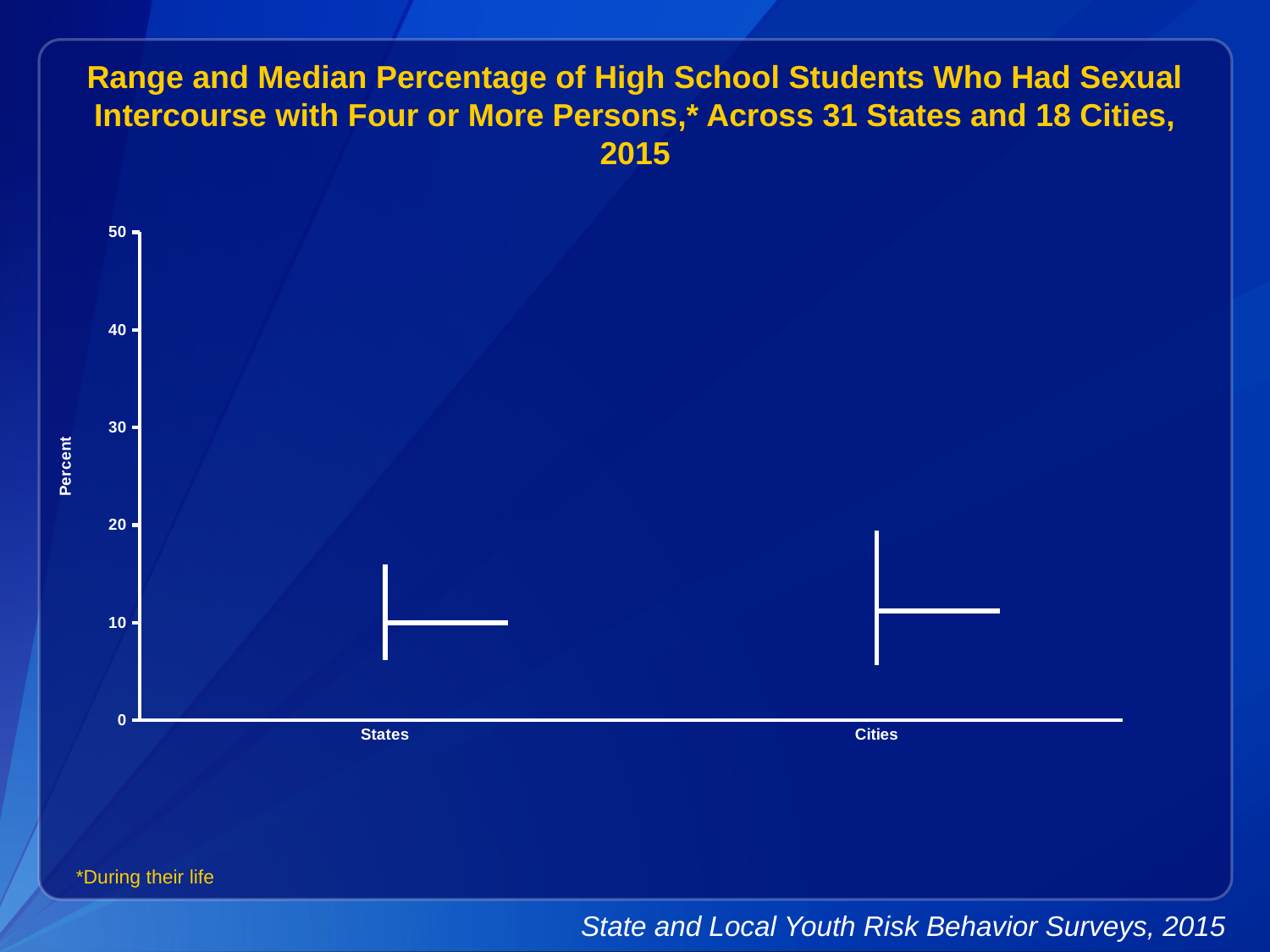
Is the median value for States greater or less than 20? less Is the upper end of the range for Cities greater or less than 10? greater Which category has the higher upper end of its range, States or Cities? Cities Is the upper end of the range for States greater or less than 20? less What are the two categories shown on the x axis? States and Cities Which category has the higher median value, States or Cities? Cities What is the label of the y axis? Percent What is the highest value shown on the y axis? 50 How many categories are shown on the x axis of the chart? 2